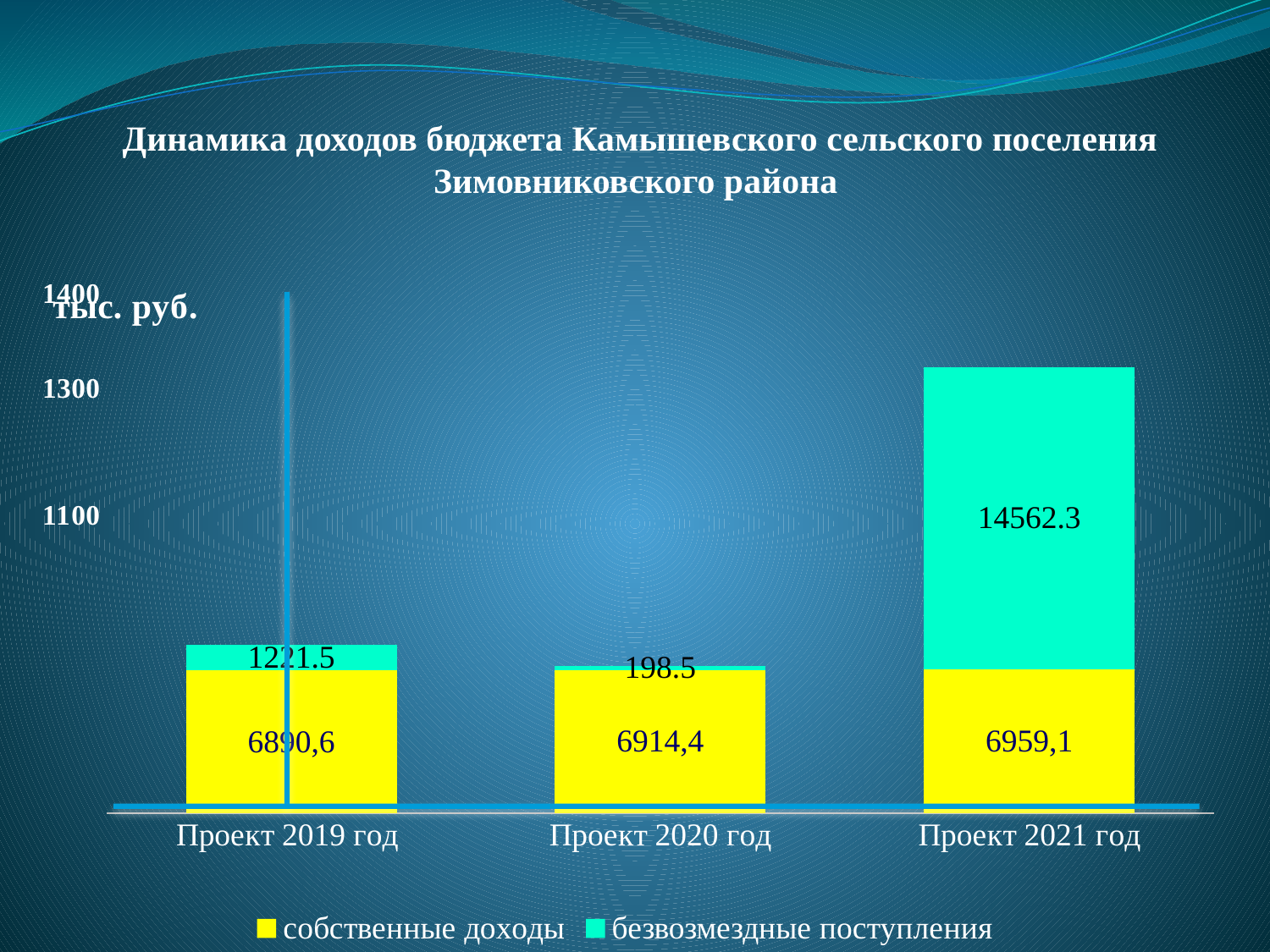
What is the value of безвозмездные поступления for Проект 2021 год? 14562.3 Which year has the highest value of безвозмездные поступления? Проект 2021 год Which year has the lowest value of безвозмездные поступления? Проект 2020 год What is the value of собственные доходы for Проект 2019 год? 6890,6 How many categories (years) are shown on the x axis? 3 What is the value of собственные доходы for Проект 2020 год? 6914,4 How many series does the legend list? 2 Do the values of собственные доходы rise or fall from Проект 2019 год to Проект 2021 год? rise Which colour represents собственные доходы in the chart? yellow What is the difference in собственные доходы between Проект 2021 год and Проект 2019 год? 68,5 What kind of chart is shown on the slide? stacked bar chart What is the value of безвозмездные поступления for Проект 2020 год? 198.5